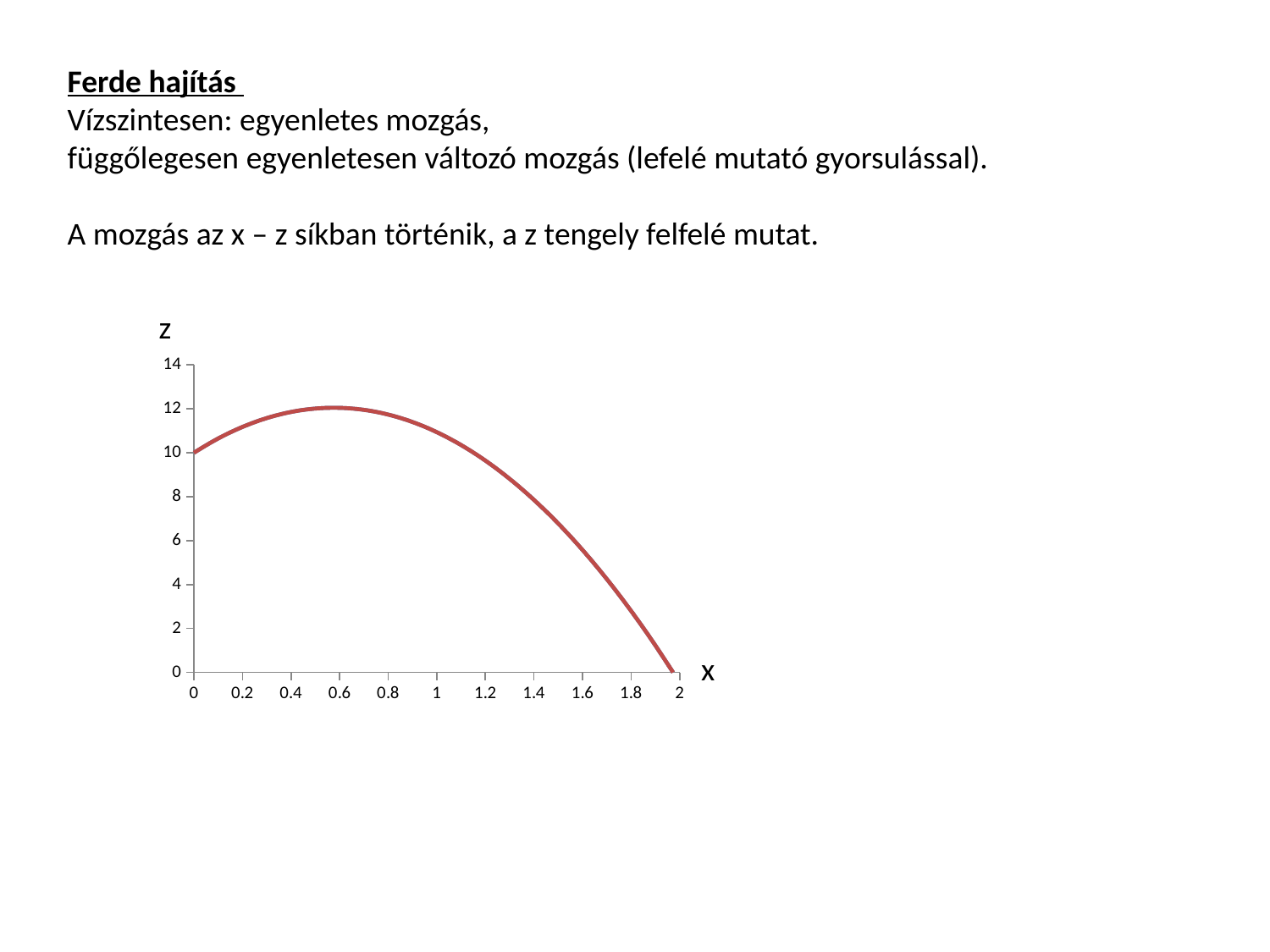
Is the value of z at x = 1.6 greater or less than 6? less What kind of chart is shown on the slide? line chart Is the value of z at x = 1.8 greater or less than 4? less What is the highest tick value shown on the vertical axis? 14 Does the curve rise or fall between x = 1 and x = 1.8? fall Is the value of z at x = 1 greater or less than 8? greater What is the value of z at x = 0? 10 Which is larger, the value of z at x = 0.6 or at x = 1.4? x = 0.6 Does the curve rise or fall between x = 0 and x = 0.4? rise What is the label of the vertical axis? z